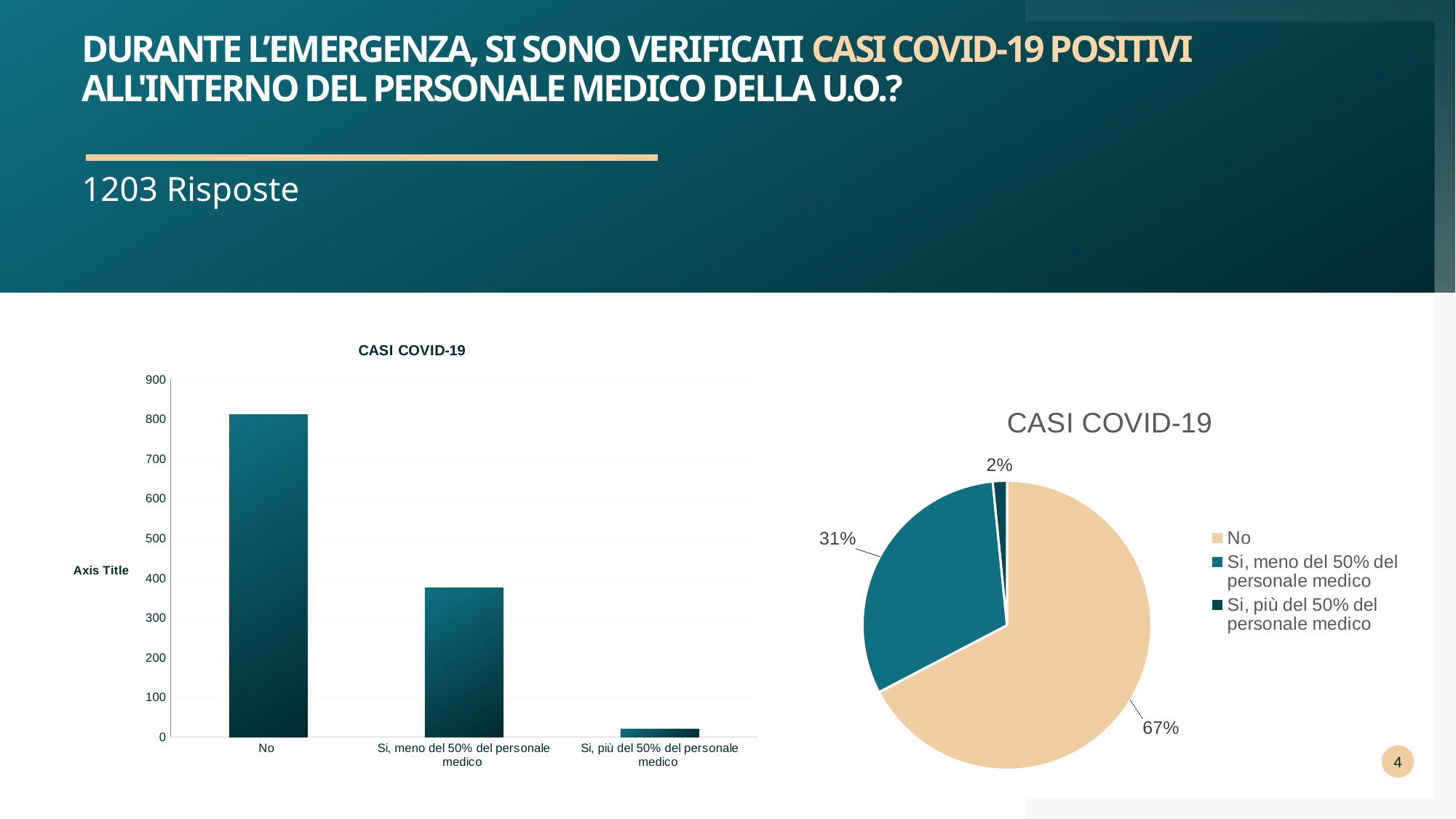
In the pie chart on the right, what is the difference in percentage points between the No slice and the 'Si, più del 50% del personale medico' slice? 65 How many categories are shown in the bar chart on the left? 3 In the pie chart on the right, what share does 'Si, meno del 50% del personale medico' have? 31% In the bar chart on the left, is the value for 'Si, più del 50% del personale medico' greater or less than 100? less In the bar chart on the left, is the value for 'Si, meno del 50% del personale medico' greater or less than 400? less How many entries does the legend of the pie chart on the right list? 3 What kind of chart is the chart on the left of the slide? bar chart In the bar chart on the left, which category has the lowest value? Si, più del 50% del personale medico In the bar chart on the left, which is larger: the value for No or the value for 'Si, meno del 50% del personale medico'? No In the pie chart on the right, what share does the No slice have? 67% In the bar chart on the left, which category has the highest value? No